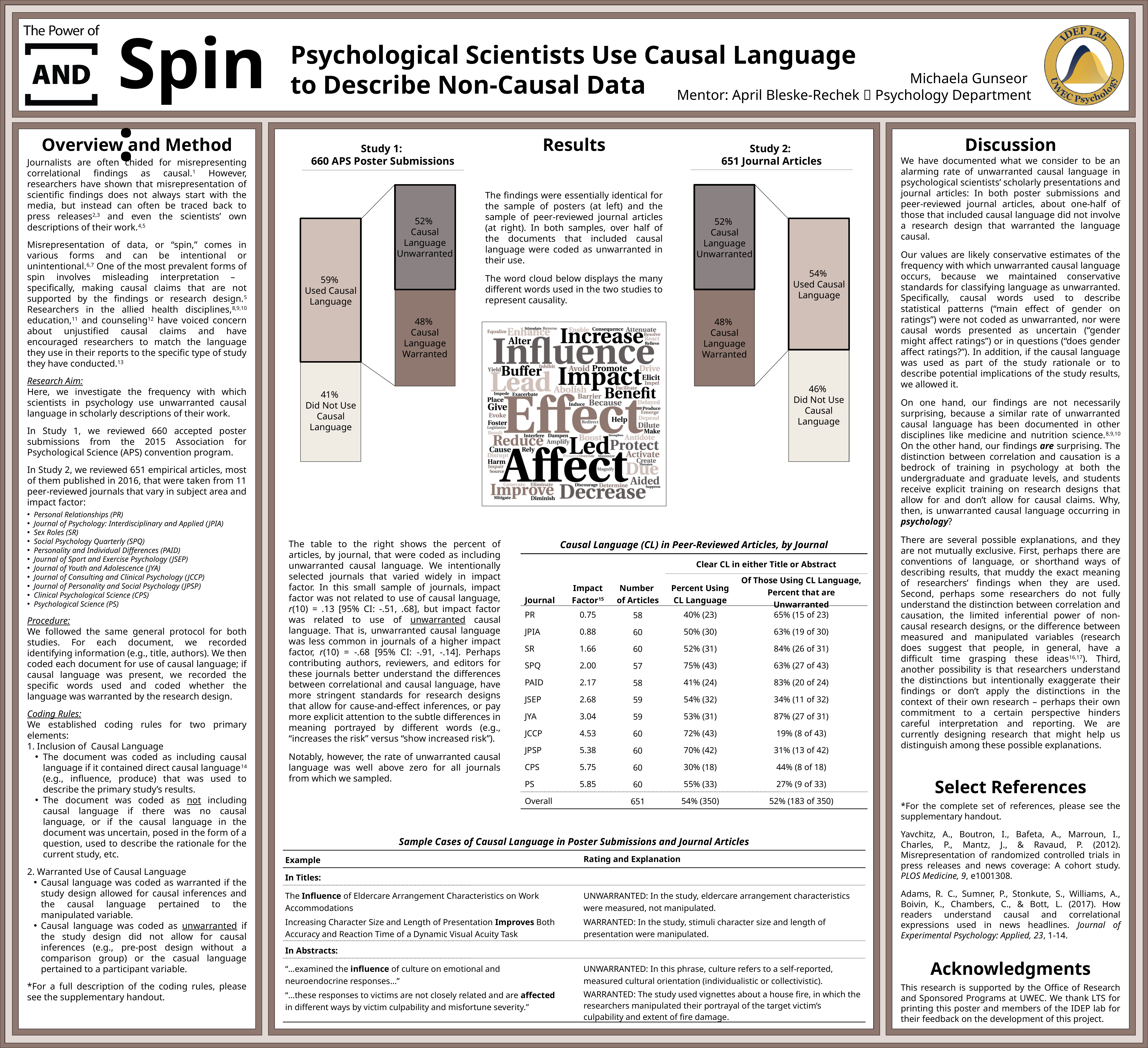
In the Study 1: 660 APS Poster Submissions chart, what percent of causal language was coded as unwarranted? 52% In the Study 1: 660 APS Poster Submissions chart, what is the difference between the percent that used causal language and the percent that did not? 18% What kind of chart is used for the Study 1: 660 APS Poster Submissions results? Stacked bar chart In the Study 2: 651 Journal Articles chart, what is the difference between the percent that used causal language and the percent that did not? 8% In the Study 1: 660 APS Poster Submissions chart, what percent of causal language was coded as warranted? 48% In the Study 1: 660 APS Poster Submissions chart, what percent of posters did not use causal language? 41% Which is larger: the percent that used causal language in the Study 1 chart or in the Study 2 chart? Study 1 In the Study 2: 651 Journal Articles chart, what is the total of the Used Causal Language and Did Not Use Causal Language segments? 100% In the Study 2: 651 Journal Articles chart, what percent of causal language was coded as unwarranted? 52% In the Study 2: 651 Journal Articles chart, what percent of articles used causal language? 54% In the Study 1: 660 APS Poster Submissions chart, what percent of posters used causal language? 59% In the Study 2: 651 Journal Articles chart, what percent of articles did not use causal language? 46%